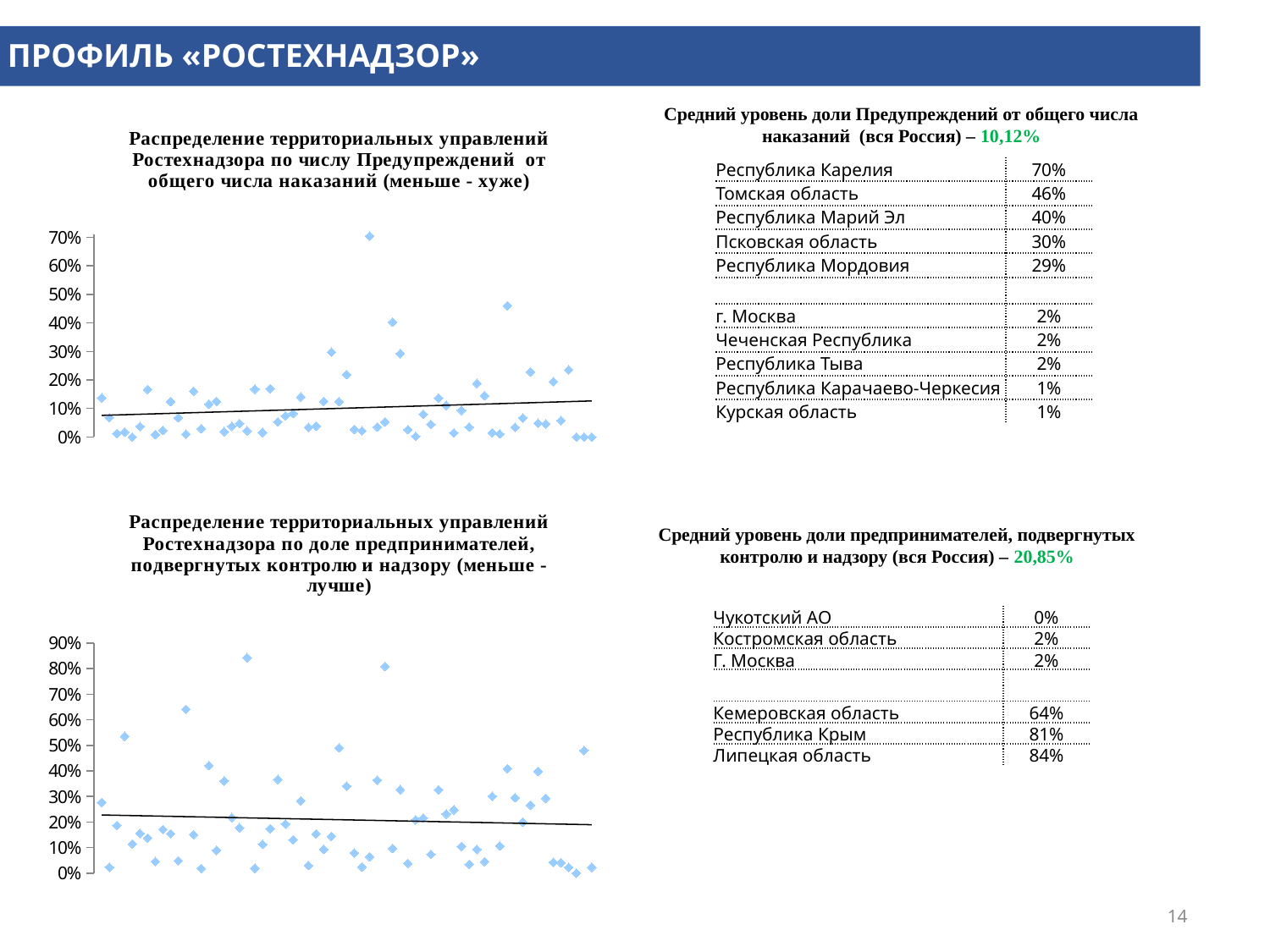
What is the highest tick value shown on the y axis of the bottom chart? 90% In the top chart, is the highest plotted point greater or less than 60%? greater In the bottom chart, is the trend line at its left end greater or less than 30%? less In the top chart, does the trend line rise or fall from left to right? rise In the top chart, is the trend line at its right end greater or less than 20%? less What kind of chart is the top chart on the slide? scatter chart In the bottom chart, does the trend line rise or fall from left to right? fall What is the highest tick value shown on the y axis of the top chart? 70% What kind of chart is the bottom chart on the slide? scatter chart